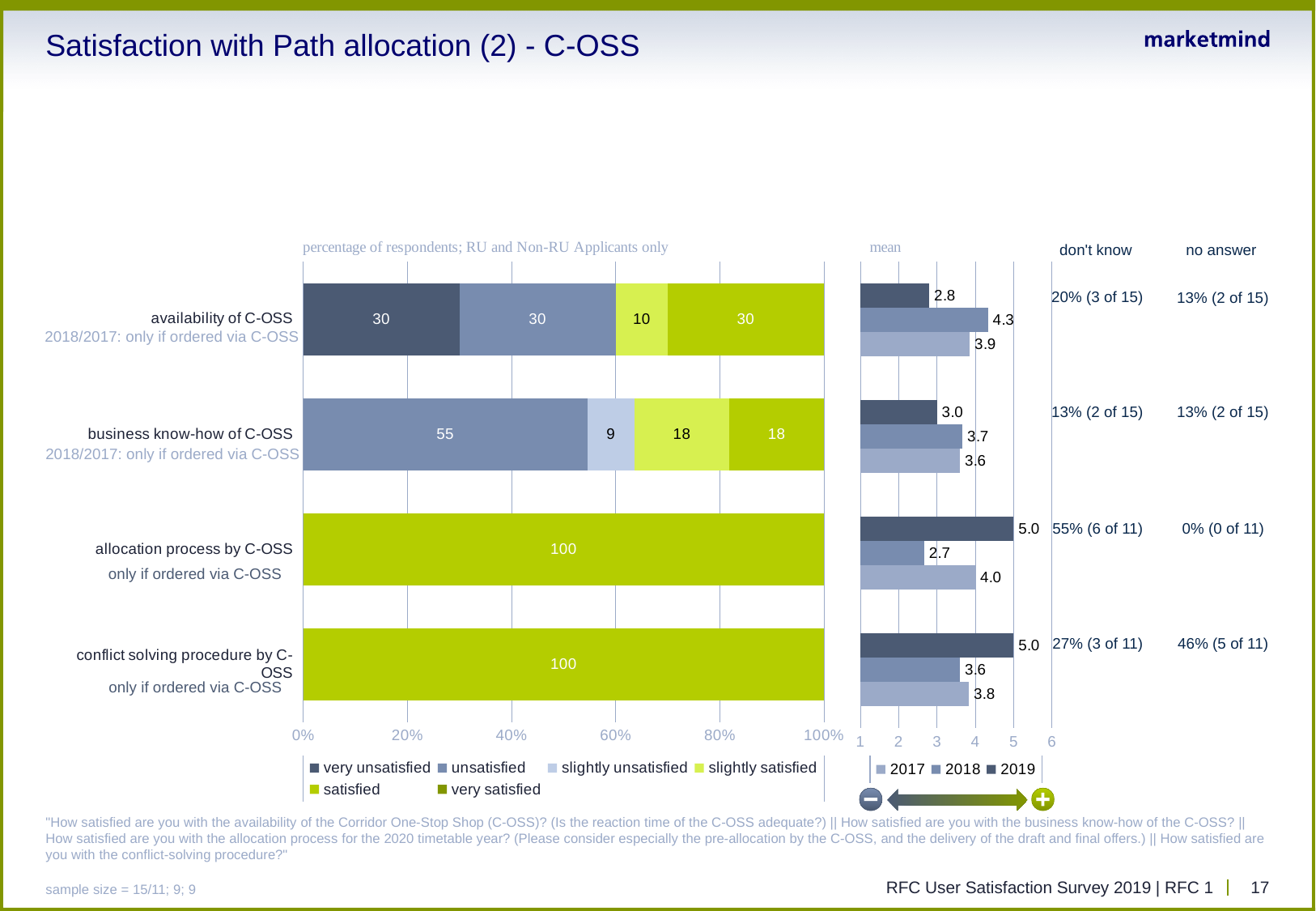
What type of chart is the mean chart on the right? bar chart In the left stacked bar chart, what is the combined percentage of slightly satisfied and satisfied respondents for the business know-how of C-OSS? 36 In the mean chart on the right, what is the 2018 mean for the allocation process by C-OSS? 2.7 How many categories are shown in the left stacked bar chart? 4 How many series does the legend of the left stacked bar chart list? 6 In the mean chart on the right, what is the 2019 mean for the availability of C-OSS? 2.8 In the left stacked bar chart, what percentage of respondents were unsatisfied with the business know-how of C-OSS? 55 In the left stacked bar chart, what percentage of respondents were very unsatisfied with the availability of C-OSS? 30 In the mean chart on the right, what is the difference between the 2018 and 2019 means for the availability of C-OSS? 1.5 In the left stacked bar chart, what percentage of respondents were satisfied with the allocation process by C-OSS? 100 In the mean chart on the right, which category has the lowest 2019 mean? availability of C-OSS In the mean chart on the right, is the 2017 mean for the conflict solving procedure by C-OSS larger or smaller than the 2018 mean? larger